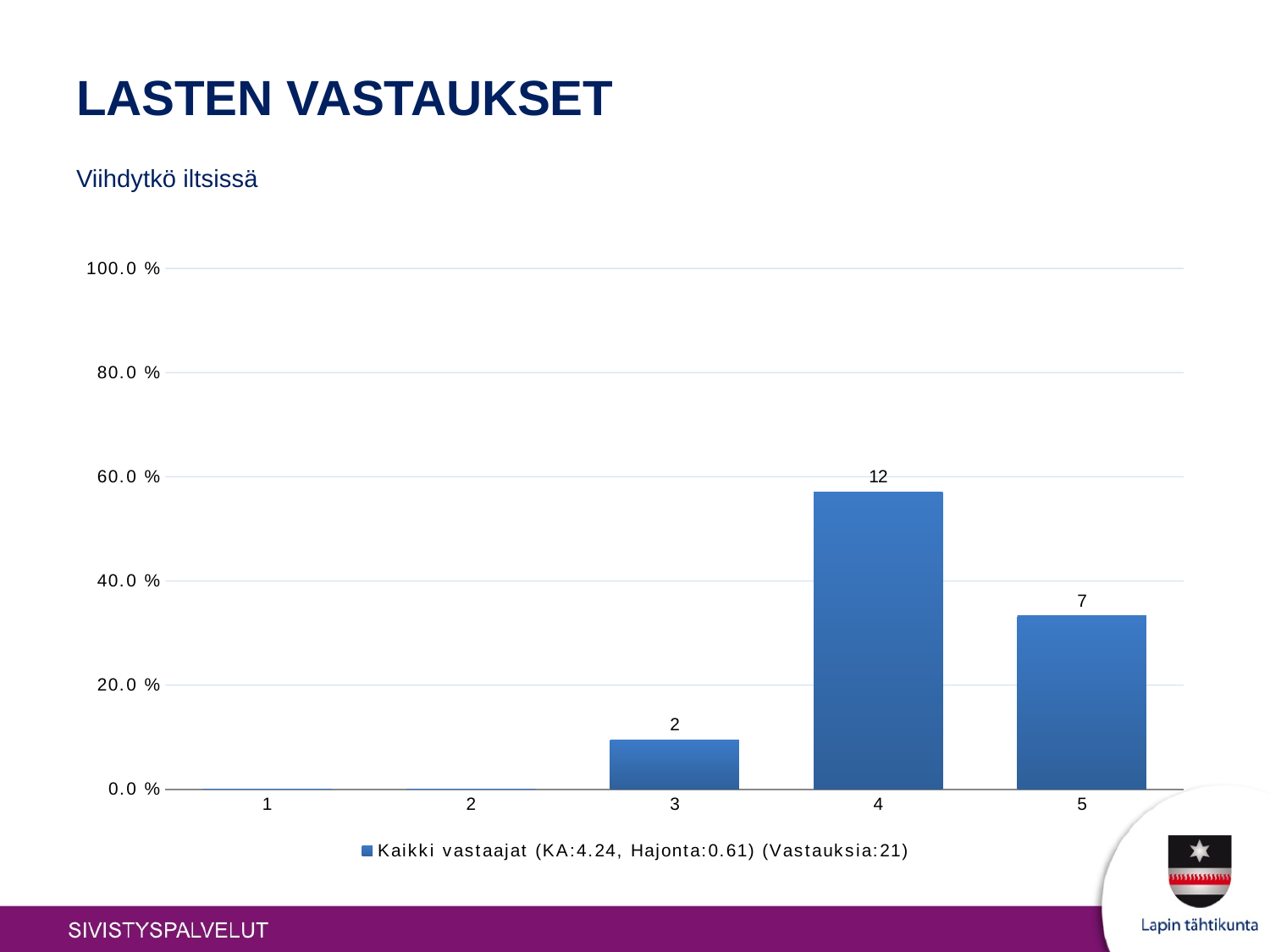
What is the difference between the data labels for categories 4 and 5? 5 Which category has the tallest bar? 4 How many categories are shown on the x axis? 5 What kind of chart is shown on the slide? bar chart How many series does the legend list? 1 What is the difference between the data labels for categories 4 and 3? 10 Which bar is taller, category 4 or category 5? 4 Is the value for category 5 greater or less than 40.0 %? less Is the value for category 4 greater or less than 40.0 %? greater What is the data label on the bar for category 3? 2 What is the data label on the bar for category 4? 12 What is the data label on the bar for category 5? 7